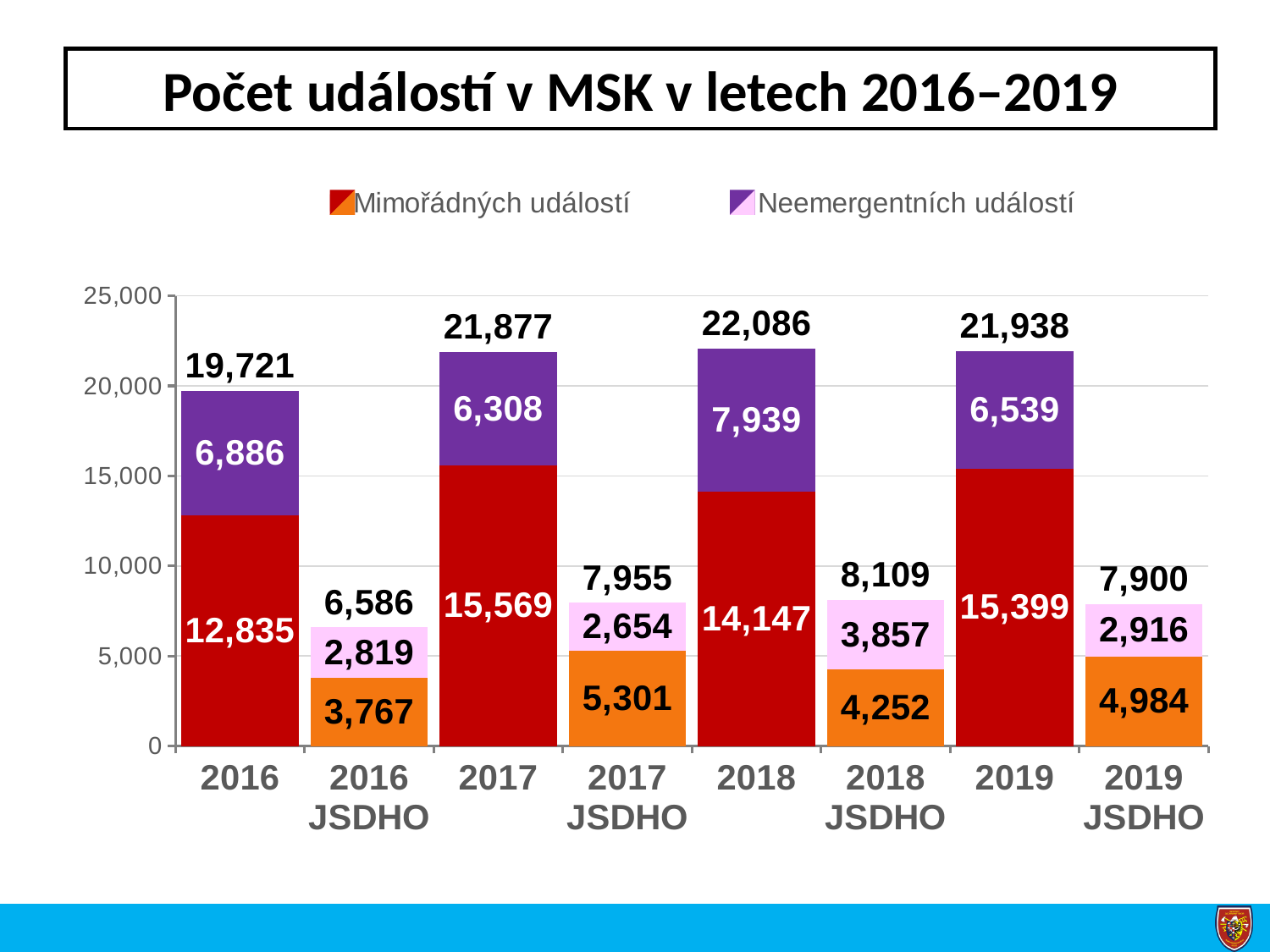
Which category has the highest total? 2018 What is the difference between the Mimořádných událostí values for 2019 and 2018? 1,252 Which category has the lowest total? 2016 JSDHO Which is larger, the Neemergentních událostí value for 2016 or for 2019? 2016 What is the value of Mimořádných událostí for 2017? 15,569 What kind of chart is shown on the slide? Stacked bar chart What is the total of the stacked bar for 2016 JSDHO? 6,586 How many series does the legend list? 2 What is the value of Neemergentních událostí for 2018 JSDHO? 3,857 How many categories are shown on the x axis? 8 What is the total of the stacked bar for 2018? 22,086 What is the title of the slide? Počet událostí v MSK v letech 2016–2019